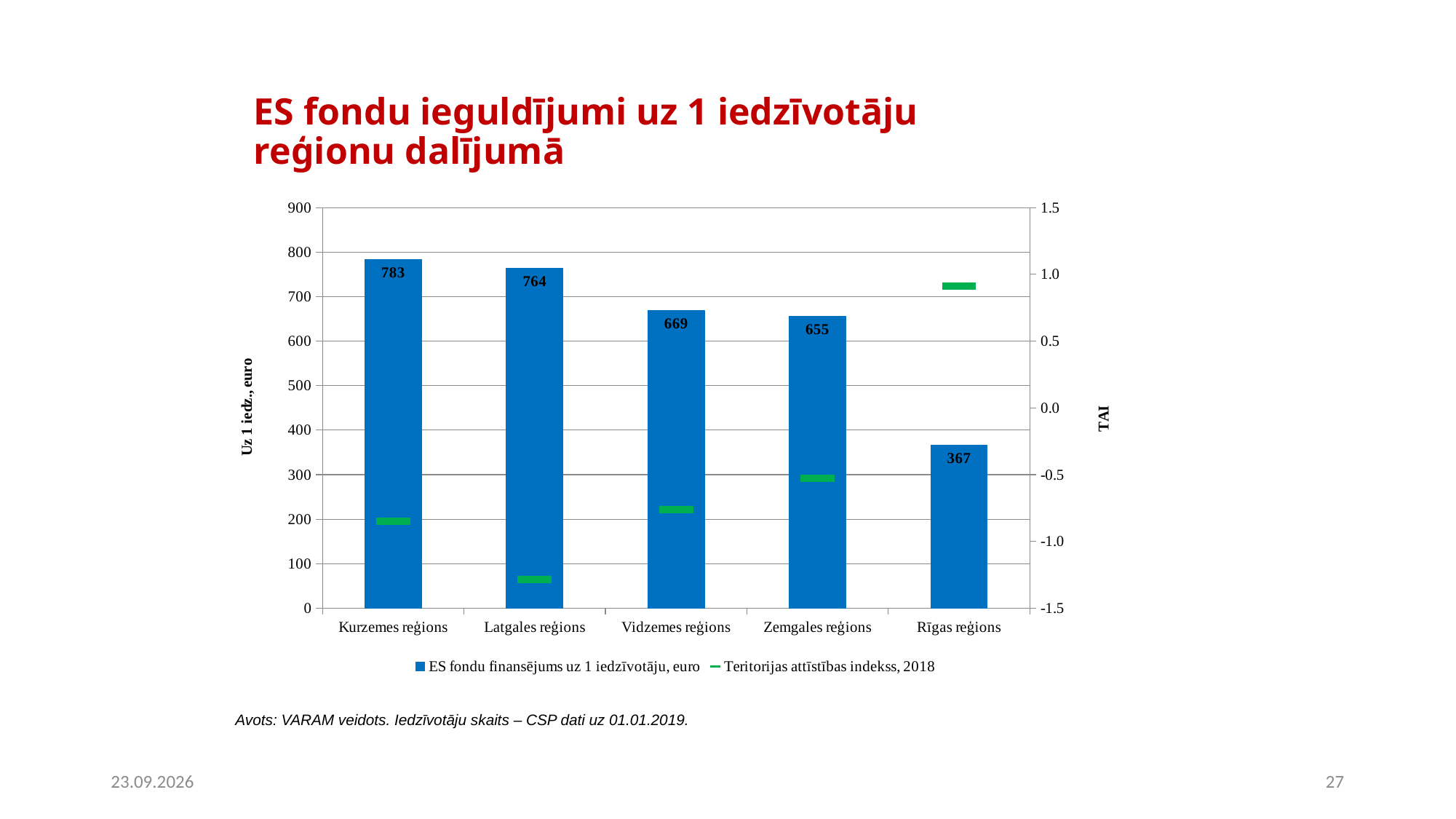
Is the Teritorijas attīstības indekss, 2018 value for Rīgas reģions greater or less than 0.5? greater Is the Teritorijas attīstības indekss, 2018 value for Latgales reģions greater or less than -1.0? less What is the difference between the ES fondu finansējums uz 1 iedzīvotāju values for Vidzemes reģions and Zemgales reģions? 14 How many regions are shown on the x axis of the chart? 5 Which region has the lowest ES fondu finansējums uz 1 iedzīvotāju? Rīgas reģions How many series does the chart legend list? 2 Which has a larger ES fondu finansējums uz 1 iedzīvotāju, Latgales reģions or Zemgales reģions? Latgales reģions What is the difference between the ES fondu finansējums uz 1 iedzīvotāju values for Kurzemes reģions and Rīgas reģions? 416 What is the ES fondu finansējums uz 1 iedzīvotāju value for Vidzemes reģions? 669 Which region has the highest ES fondu finansējums uz 1 iedzīvotāju? Kurzemes reģions What is the ES fondu finansējums uz 1 iedzīvotāju value for Rīgas reģions? 367 What is the ES fondu finansējums uz 1 iedzīvotāju value for Kurzemes reģions? 783